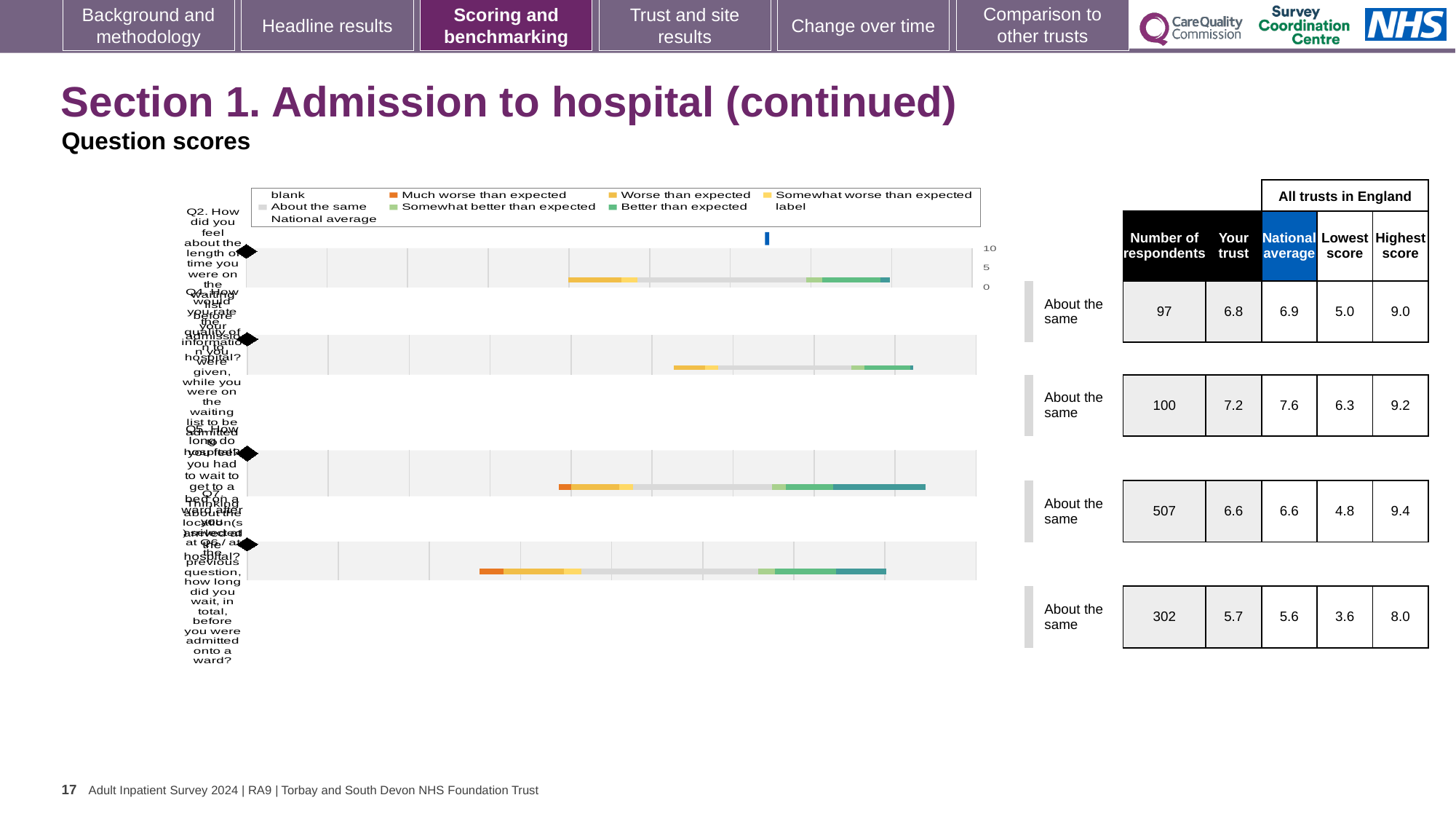
What colour does the legend use for 'Much worse than expected'? orange In the table beside the chart, what is the number of respondents for the first row? 97 In the table beside the chart, which row has the lowest 'Your trust' score? the fourth row (5.7) How many horizontal bars (question rows) does the chart contain? 4 What is the highest tick value shown on the chart's axis? 10 In the table beside the chart, what is the 'Your trust' score for the second row? 7.2 What kind of chart is shown on the slide? bar chart In the first row of the table beside the chart, what is the difference between the highest score and the lowest score? 4.0 In the table beside the chart, which row has the highest number of respondents? the third row (507) What benchmark category is shown beside every bar in the chart? About the same In the table beside the chart, what is the lowest score for the fourth row? 3.6 In the second row of the table beside the chart, which is larger: the 'Your trust' score or the national average? National average